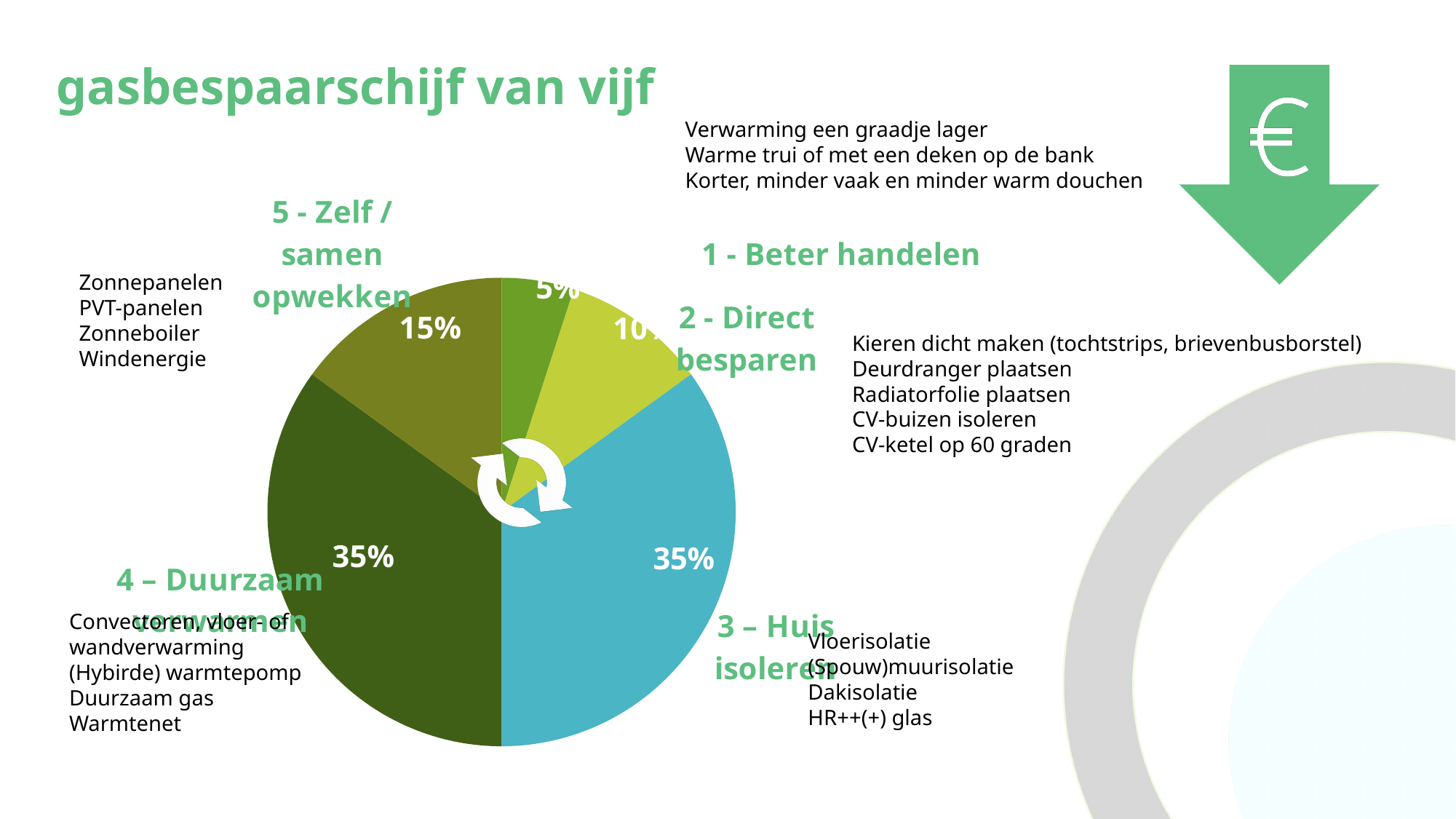
What share of the pie does '5 - Zelf / samen opwekken' have? 15% How many slices does the pie chart have? 5 What share of the pie does '1 - Beter handelen' have? 5% What share of the pie does '4 – Duurzaam verwarmen' have? 35% What share of the pie does '3 – Huis isoleren' have? 35% What kind of chart is shown on the slide? pie chart What is the difference in percentage points between '5 - Zelf / samen opwekken' and '1 - Beter handelen'? 10 What is the title of the slide containing the pie chart? gasbespaarschijf van vijf Which slice is larger: '5 - Zelf / samen opwekken' or '2 - Direct besparen'? 5 - Zelf / samen opwekken Which slice is larger: '1 - Beter handelen' or '5 - Zelf / samen opwekken'? 5 - Zelf / samen opwekken What do the slices '3 – Huis isoleren' and '4 – Duurzaam verwarmen' add up to? 70% Which slice of the pie chart is the smallest? 1 - Beter handelen